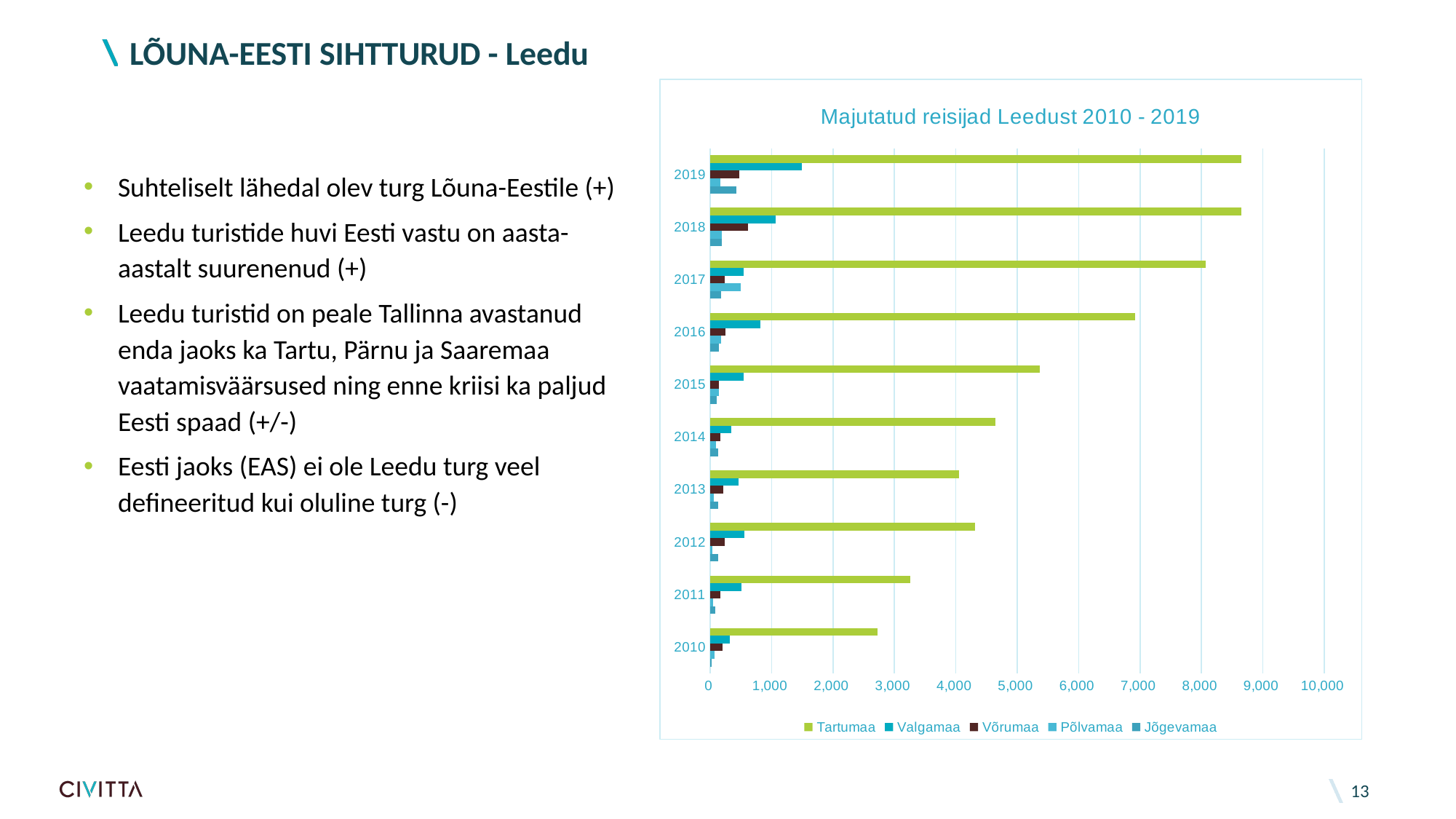
Which is larger, the Tartumaa value for 2019 or the Tartumaa value for 2010? 2019 Is the Valgamaa value for 2019 greater or less than 1,000? greater Is the Tartumaa value for 2010 greater or less than 3,000? less Do the Tartumaa values generally rise or fall from 2010 to 2019? rise How many years are shown on the chart's vertical axis? 10 In which year is the Tartumaa value lowest? 2010 How many series does the chart legend list? 5 Is the Tartumaa value for 2015 greater or less than 5,000? greater Which series is listed first in the chart legend? Tartumaa What type of chart is shown on the slide? bar chart What is the title of the chart? Majutatud reisijad Leedust 2010 - 2019